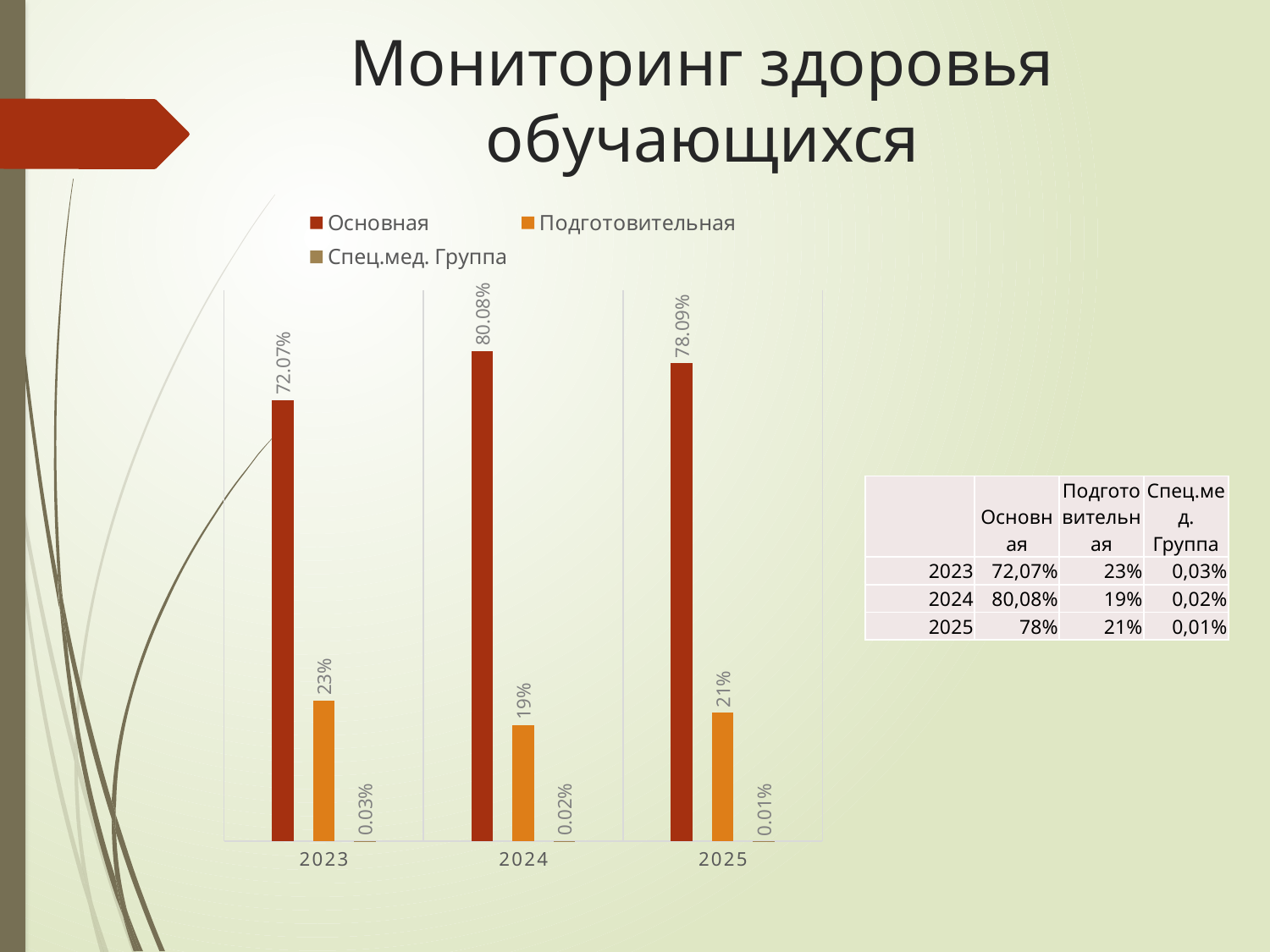
What is the difference between the Подготовительная values for 2023 and 2024? 4% What is the value for Основная in 2024? 80.08% How many series does the legend list? 3 In which year is the Подготовительная value lowest? 2024 Which is larger: the Основная value for 2024 or for 2025? 2024 How many years are shown on the x axis? 3 What is the value for Подготовительная in 2023? 23% What is the value for Основная in 2023? 72.07% Do the Спец.мед. Группа values rise or fall from 2023 to 2025? fall What kind of chart is shown on the slide? bar chart What is the value for Спец.мед. Группа in 2025? 0.01% In which year is the Основная value highest? 2024